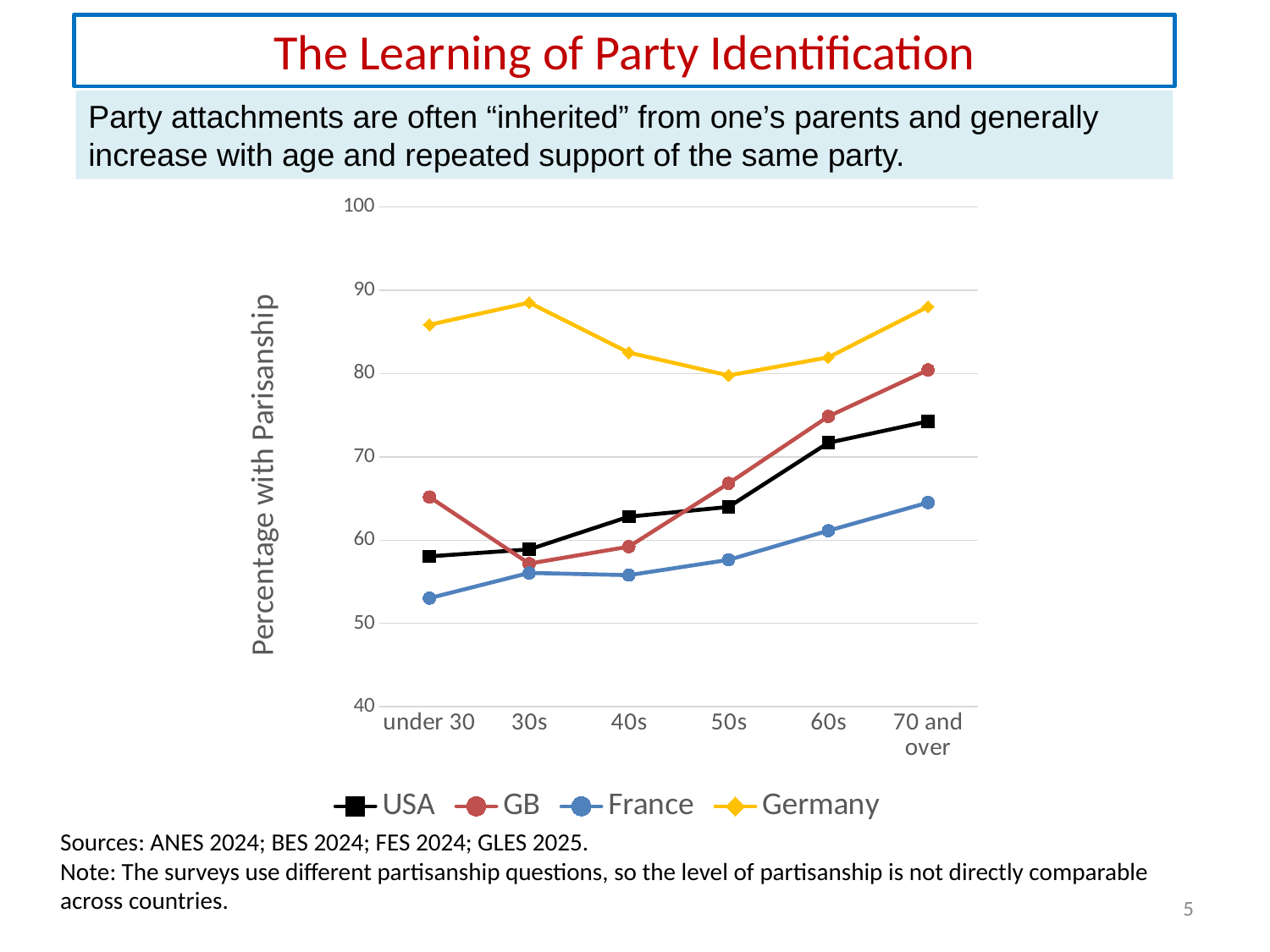
Is the value for Germany in the under 30 group greater or less than 80? greater How many series does the legend list? 4 Is the value for USA in the 70 and over group greater or less than 70? greater What is the label on the vertical axis of the chart? Percentage with Parisanship Is the value for GB in the 60s group greater or less than 70? greater Does the France line rise or fall from under 30 to 70 and over? rise Which country has the lowest percentage with partisanship for the 70 and over group? France What kind of chart is shown on the slide? line chart How many age groups are shown on the x axis? 6 Which country has the highest percentage with partisanship for the under 30 group? Germany For the under 30 group, which is larger, the value for USA or the value for GB? GB